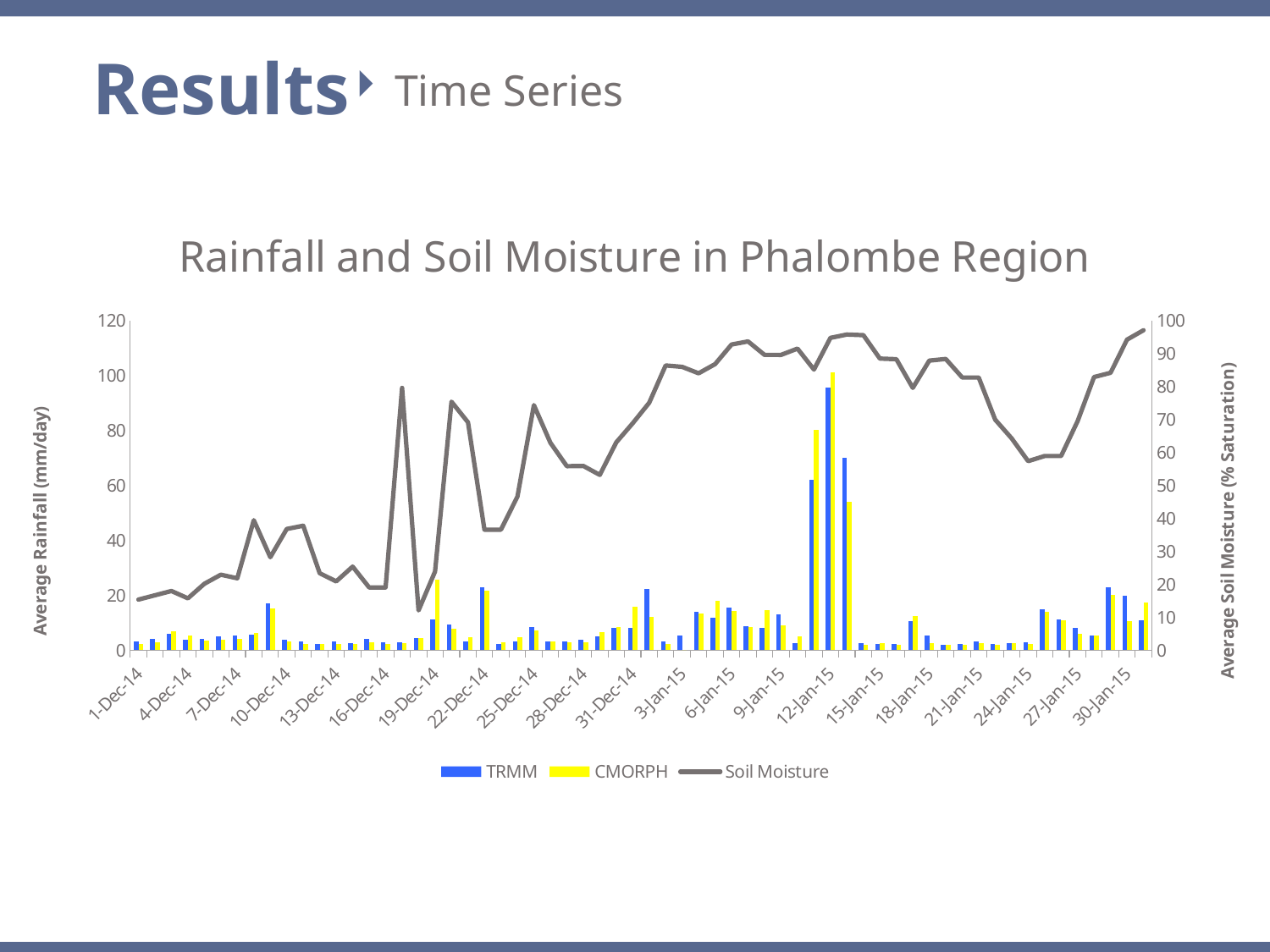
How many date labels are shown on the x axis? 21 Is the Soil Moisture value on 19-Dec-14 greater or less than 70? less Overall, does the Soil Moisture line rise or fall from 1-Dec-14 to 30-Jan-15? rise Which is larger, the Soil Moisture value on 1-Dec-14 or on 30-Jan-15? 30-Jan-15 Which series is plotted as a line rather than bars? Soil Moisture How many series does the legend list? 3 What kind of chart is shown on the slide? A combined bar and line chart Is the highest TRMM rainfall value greater or less than 80? greater Is the Soil Moisture value on 1-Dec-14 greater or less than 20? less What is the title of the chart? Rainfall and Soil Moisture in Phalombe Region